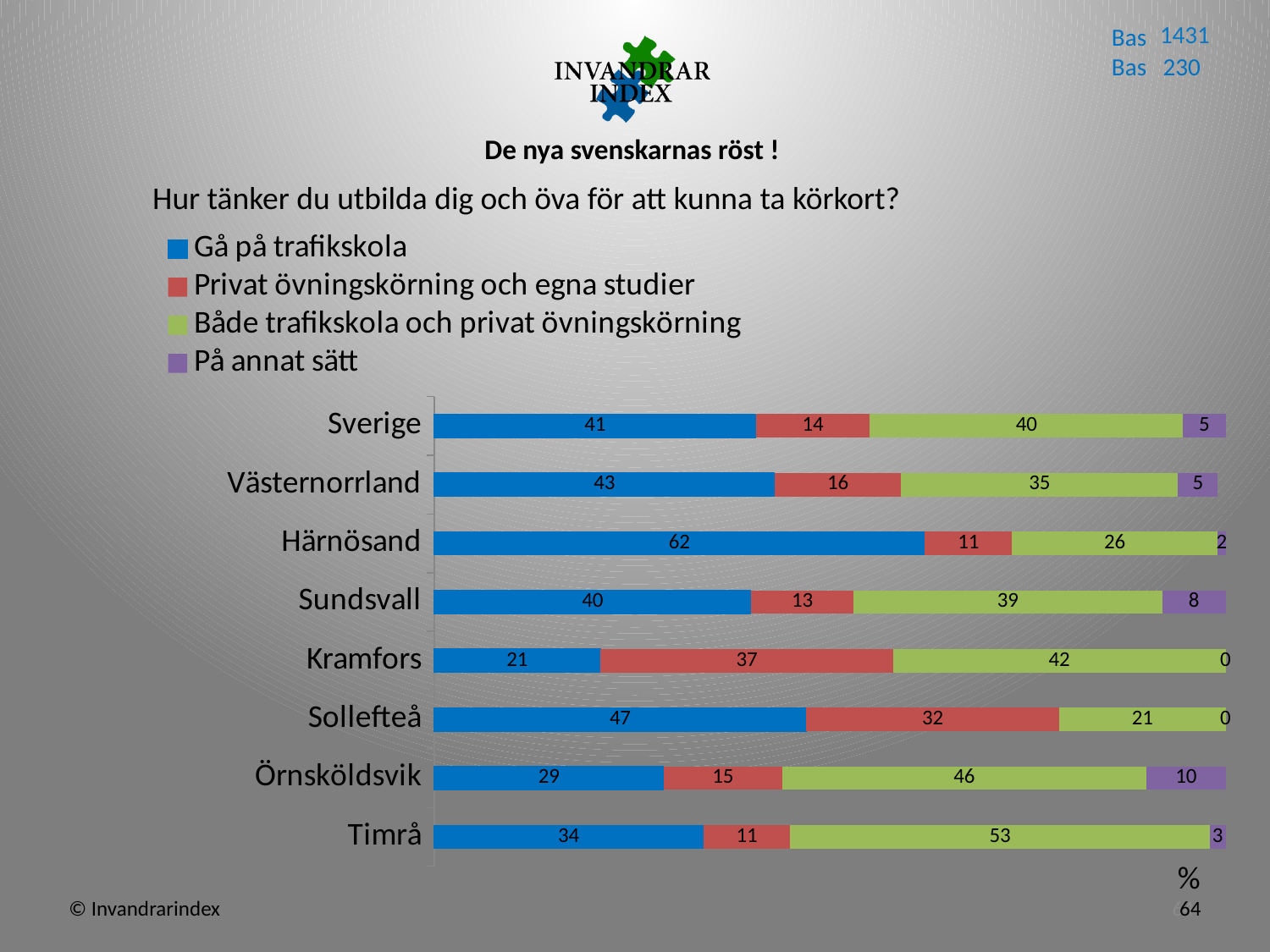
What is the value for "Gå på trafikskola" for Härnösand? 62 How many series does the legend list? 4 How many categories are shown on the chart? 8 What is the difference between the "Gå på trafikskola" values for Sollefteå and Sverige? 6 What is the total of the stacked bar for Sundsvall? 100 What is the value for "Både trafikskola och privat övningskörning" for Timrå? 53 What kind of chart is shown on the slide? Stacked bar chart What is the value for "På annat sätt" for Örnsköldsvik? 10 What is the value for "Privat övningskörning och egna studier" for Kramfors? 37 Which is larger: the "Både trafikskola och privat övningskörning" value for Sundsvall or for Västernorrland? Sundsvall Which category has the lowest value for "Gå på trafikskola"? Kramfors Which category has the highest value for "Gå på trafikskola"? Härnösand